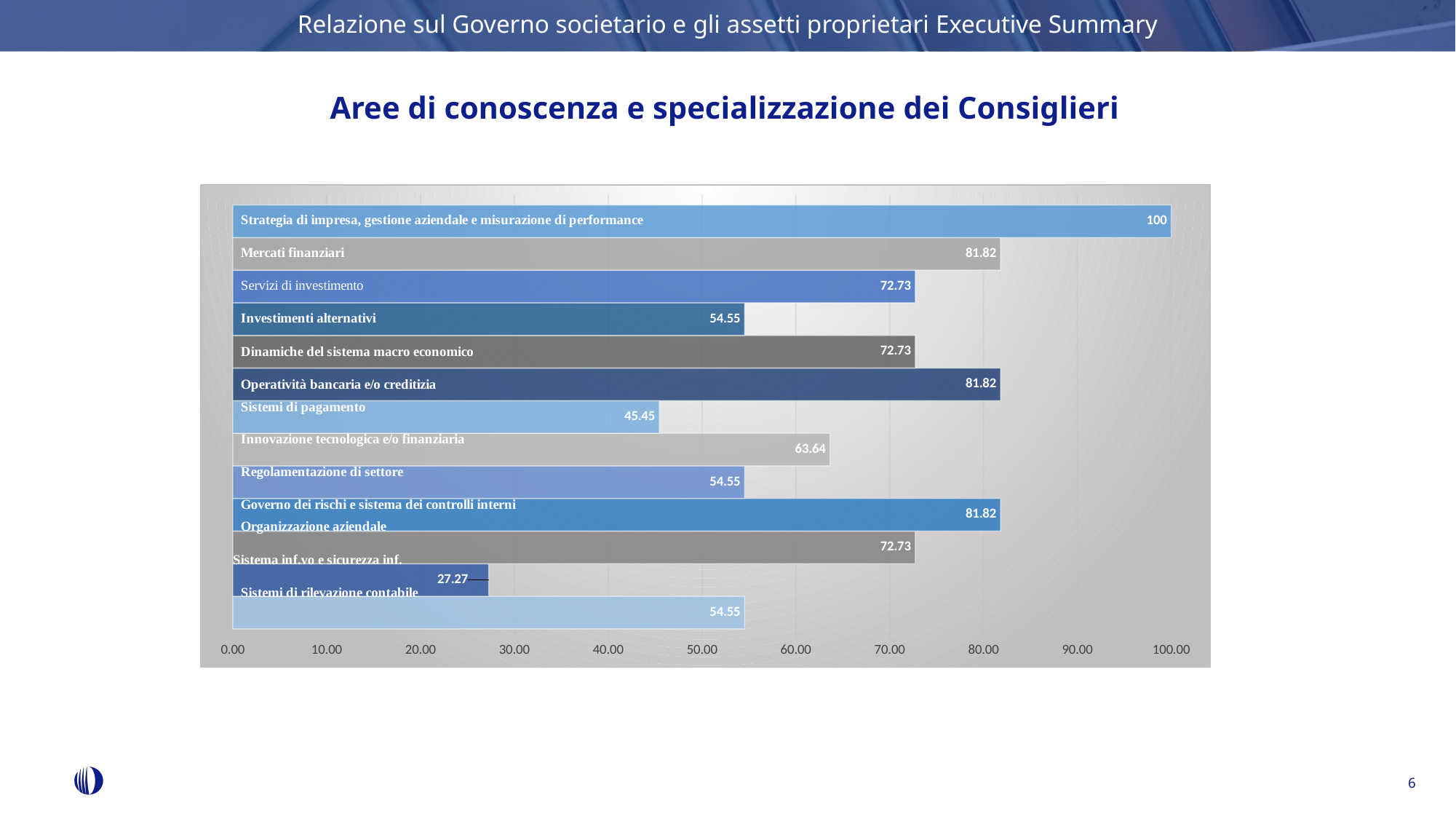
Is the value for Operatività bancaria e/o creditizia greater or less than 70.00? greater What value is shown for Sistemi di pagamento? 45.45 What value is shown for Investimenti alternativi? 54.55 What value is shown for Innovazione tecnologica e/o finanziaria? 63.64 Which is larger, the value for Innovazione tecnologica e/o finanziaria or the value for Regolamentazione di settore? Innovazione tecnologica e/o finanziaria What kind of chart is shown on the slide? Bar chart Which category has the highest value? Strategia di impresa, gestione aziendale e misurazione di performance How many categories are shown in the chart? 13 What is the difference between the values for Mercati finanziari and Servizi di investimento? 9.09 Which category has the lowest value? Sistema inf.vo e sicurezza inf. What value is shown for Mercati finanziari? 81.82 What is the title of the chart on the slide? Aree di conoscenza e specializzazione dei Consiglieri